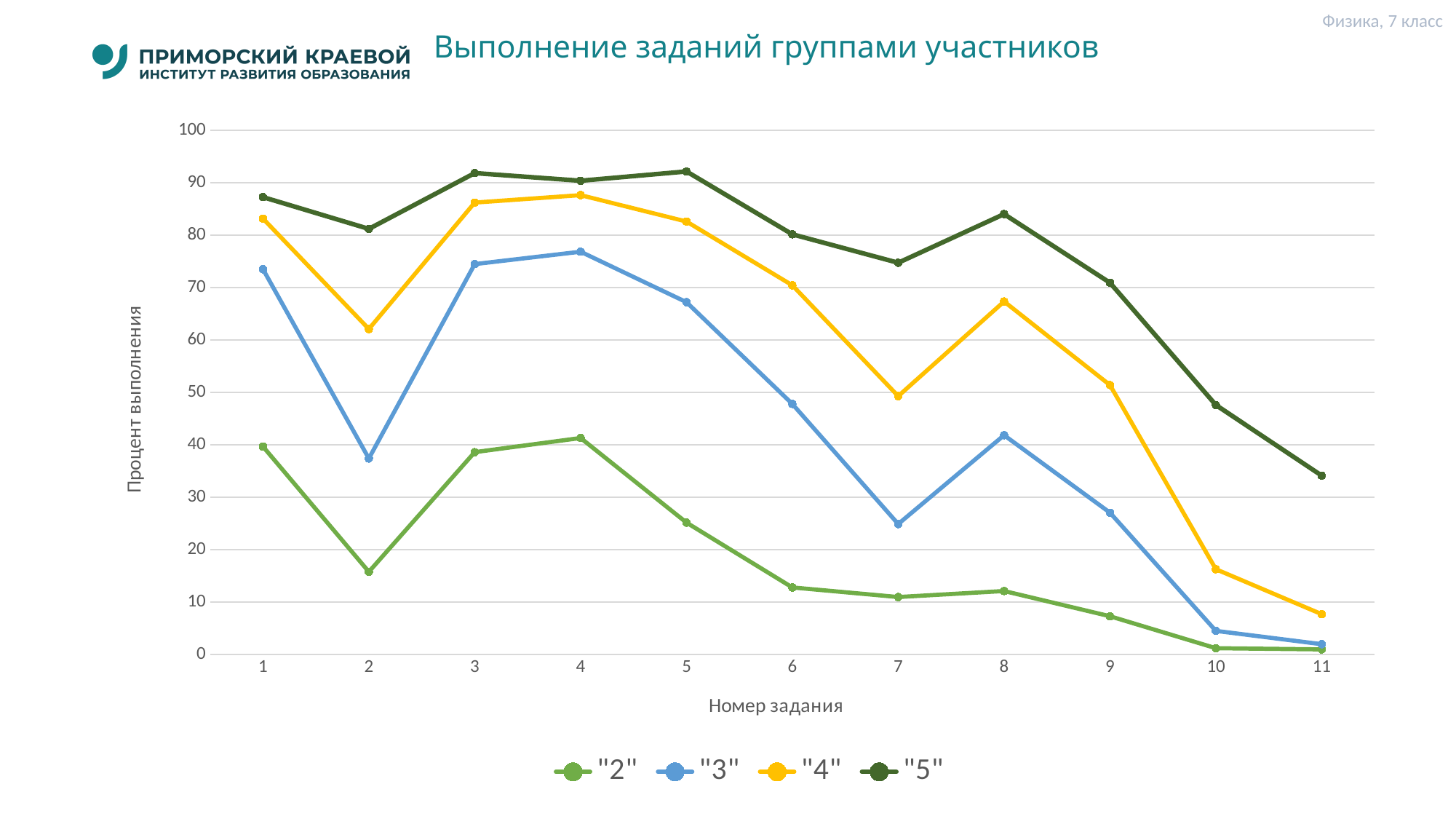
Is the value for series "4" at task 10 greater or less than 20? less What is the title of the vertical axis? Процент выполнения Is the value for series "2" at task 2 greater or less than 20? less How many series does the legend list? 4 How many task numbers are plotted along the x axis? 11 Is the value for series "3" at task 7 greater or less than 30? less For series "3", at which task number is the value highest? 4 At task 2, which series has the larger value, "4" or "3"? "4" Do the values for series "5" rise or fall from task 8 to task 11? fall For series "5", at which task number is the value lowest? 11 What kind of chart is shown on the slide? line chart